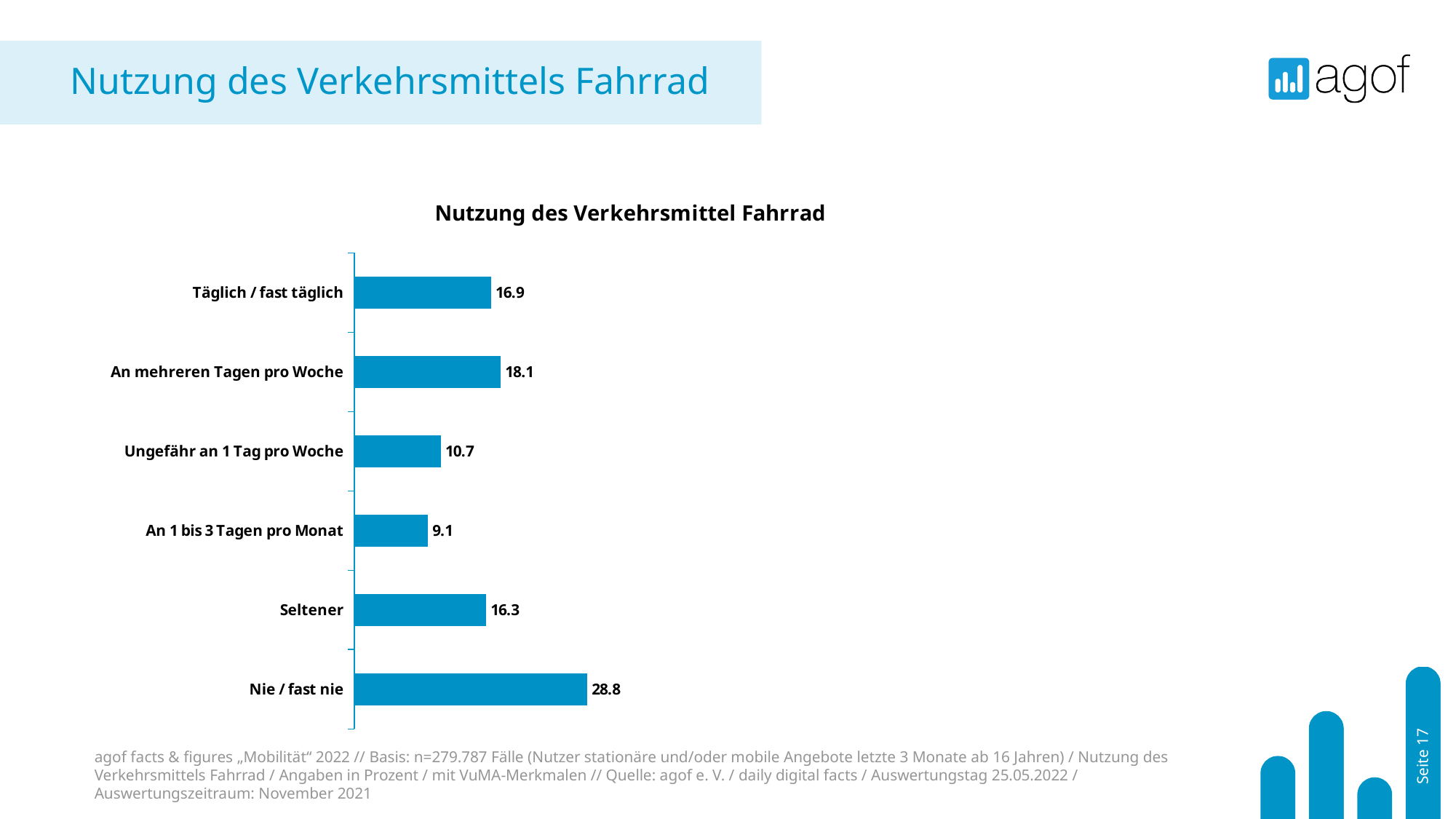
Which category has the highest value? Nie / fast nie What is the difference between the values for "An mehreren Tagen pro Woche" and "Ungefähr an 1 Tag pro Woche"? 7.4 Which category has the lowest value? An 1 bis 3 Tagen pro Monat What is the value for "An mehreren Tagen pro Woche"? 18.1 How many categories are shown in the chart? 6 What kind of chart is shown on the slide? Bar chart What is the value for "Nie / fast nie"? 28.8 What is the difference between the values for "Nie / fast nie" and "Seltener"? 12.5 What is the value for "Täglich / fast täglich"? 16.9 What is the value for "Ungefähr an 1 Tag pro Woche"? 10.7 What is the title of the chart? Nutzung des Verkehrsmittel Fahrrad Which is larger, the value for "Täglich / fast täglich" or the value for "Seltener"? Täglich / fast täglich